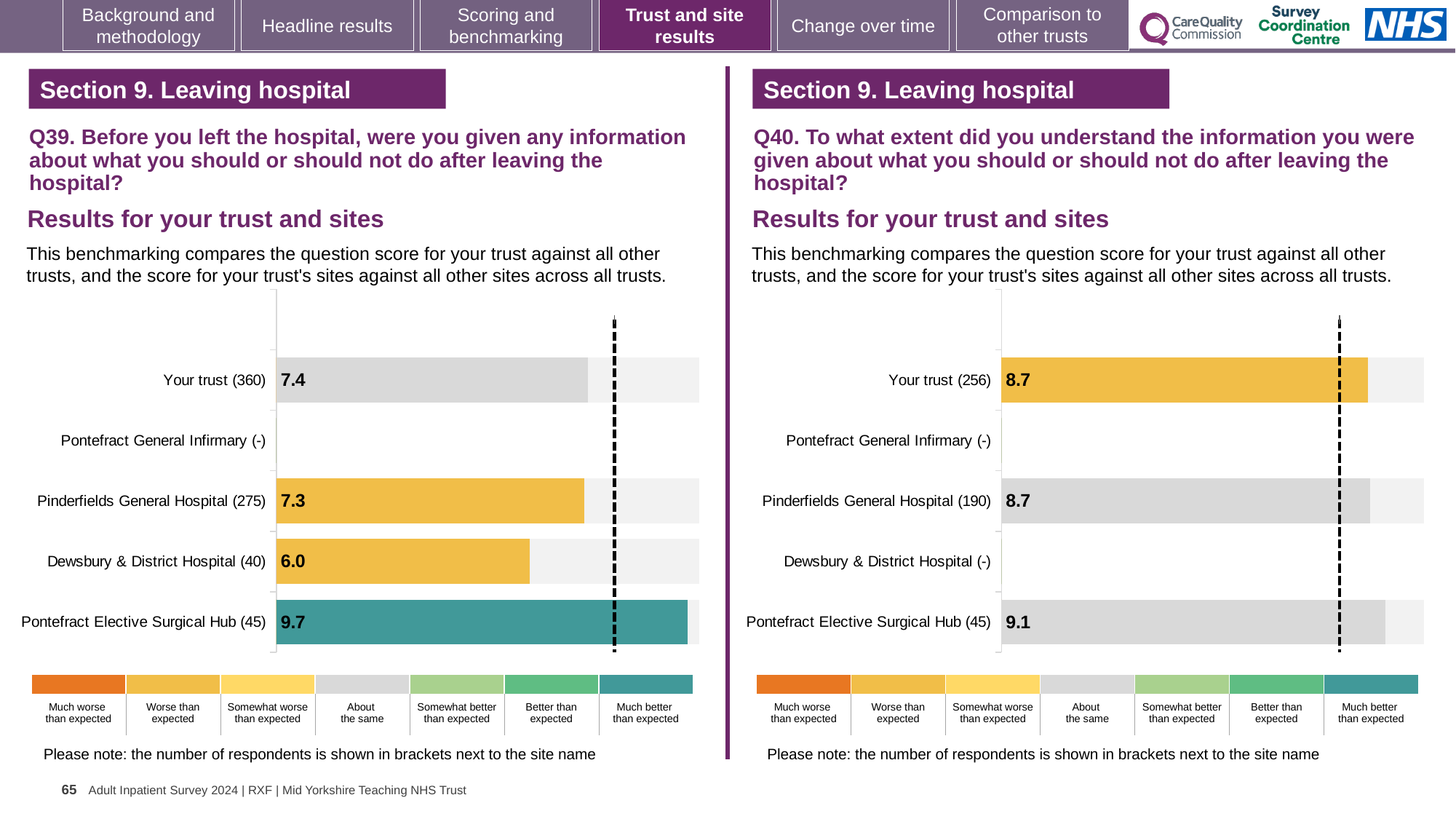
In the Q39 chart on the left, what is the difference between the scores for Pontefract Elective Surgical Hub and Dewsbury & District Hospital? 3.7 In the Q39 chart on the left, how many respondents are shown for Pinderfields General Hospital? 275 In the Q40 chart on the right, how many rows have a score shown? 3 In the Q39 chart on the left, which site with a score shown has the lowest score? Dewsbury & District Hospital In the Q39 chart on the left, what is the score for Your trust? 7.4 In the Q39 chart on the left, which site has the highest score? Pontefract Elective Surgical Hub In the Q40 chart on the right, which site has the highest score? Pontefract Elective Surgical Hub What type of chart is used on the left for Q39? Bar chart In the Q39 chart on the left, what is the score for Dewsbury & District Hospital? 6.0 In the Q40 chart on the right, what is the score for Pinderfields General Hospital? 8.7 In the Q40 chart on the right, what is the difference between the scores for Pontefract Elective Surgical Hub and Your trust? 0.4 In the Q40 chart on the right, what is the score for Pontefract Elective Surgical Hub? 9.1